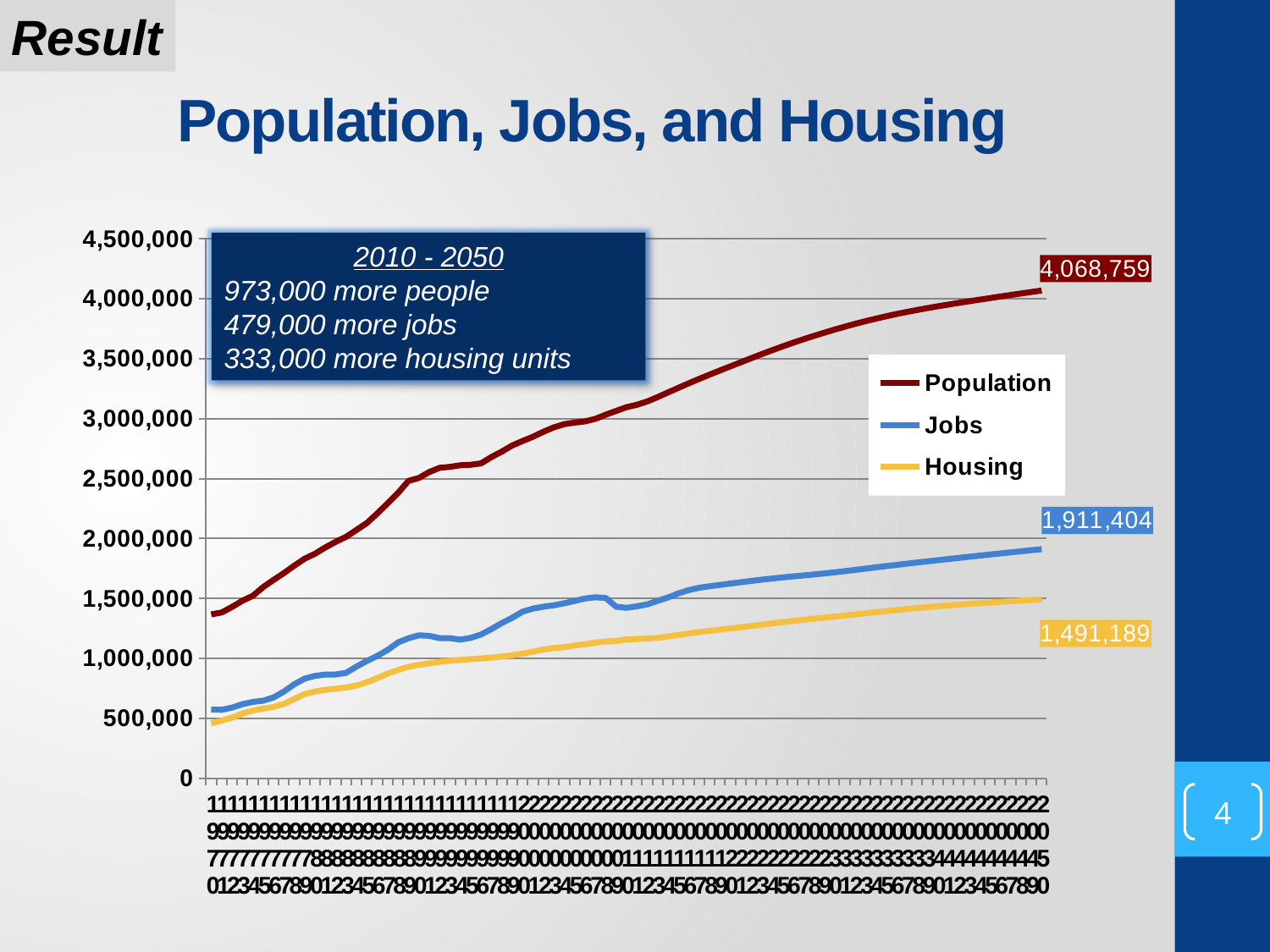
What is the final labelled value of the Housing series? 1,491,189 What is the final labelled value of the Population series? 4,068,759 How many series does the legend list? 3 What is the title of the chart? Population, Jobs, and Housing What kind of chart is shown on the slide? Line chart Do the values of the Population series rise or fall over time along the x axis? Rise Which series has the lowest value at the end of the chart? Housing Which series has the highest value at the end of the chart? Population Is the value of the Population series at the start of the chart greater or less than 1,500,000? less What is the final labelled value of the Jobs series? 1,911,404 At the end of the chart, which is larger: Jobs or Housing? Jobs What is the difference between the final labelled Jobs value and the final labelled Housing value? 420,215